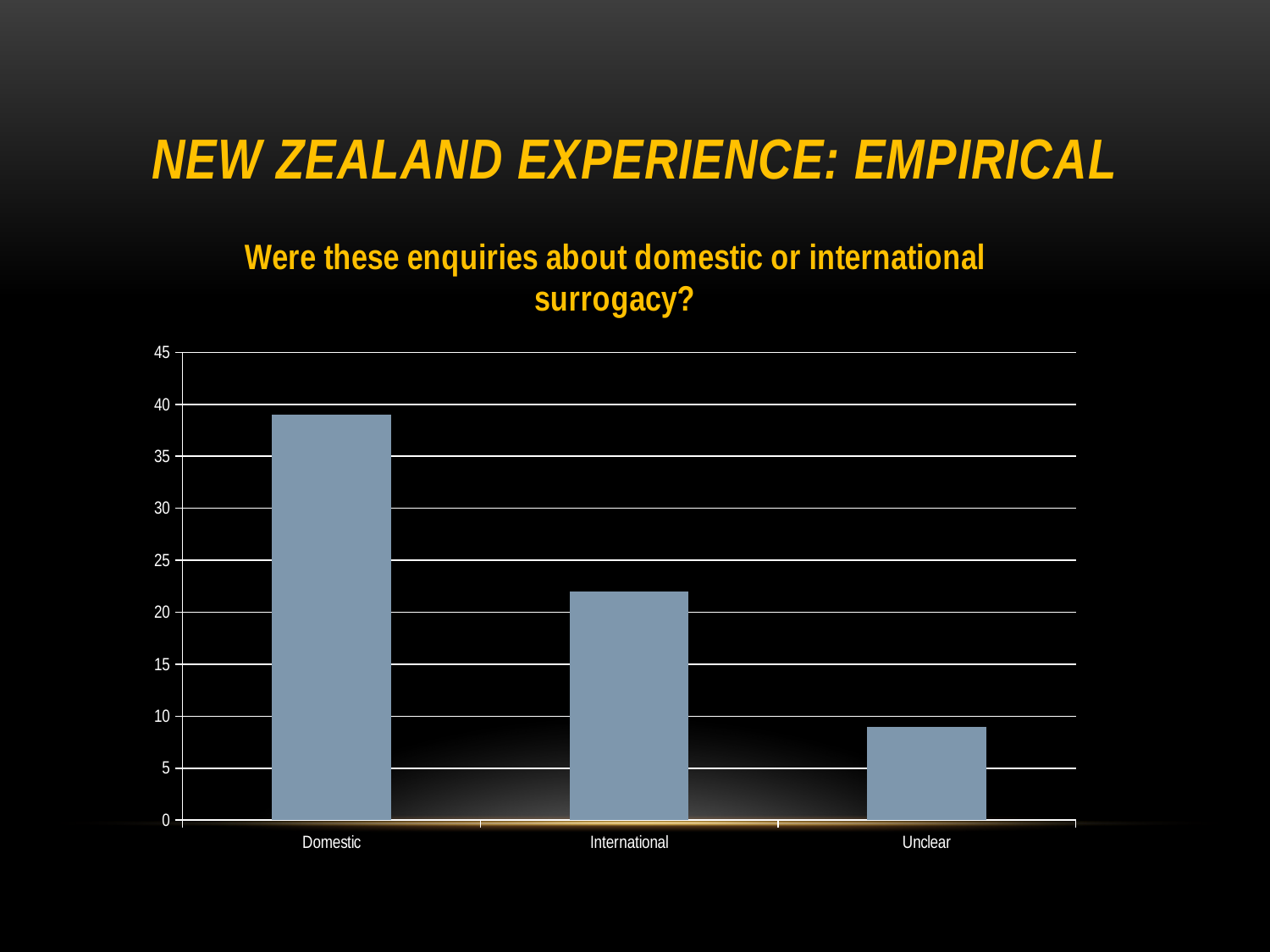
Which is larger, the value for International or the value for Unclear? International Which category has the highest value? Domestic How many categories are shown on the x axis? 3 Is the value for Domestic greater or less than 35? greater What kind of chart is shown on the slide? bar chart Do the values rise or fall from left to right across the categories? fall Is the value for International greater or less than 15? greater Is the value for International greater or less than 25? less Which category has the lowest value? Unclear Which is larger, the value for Domestic or the value for International? Domestic